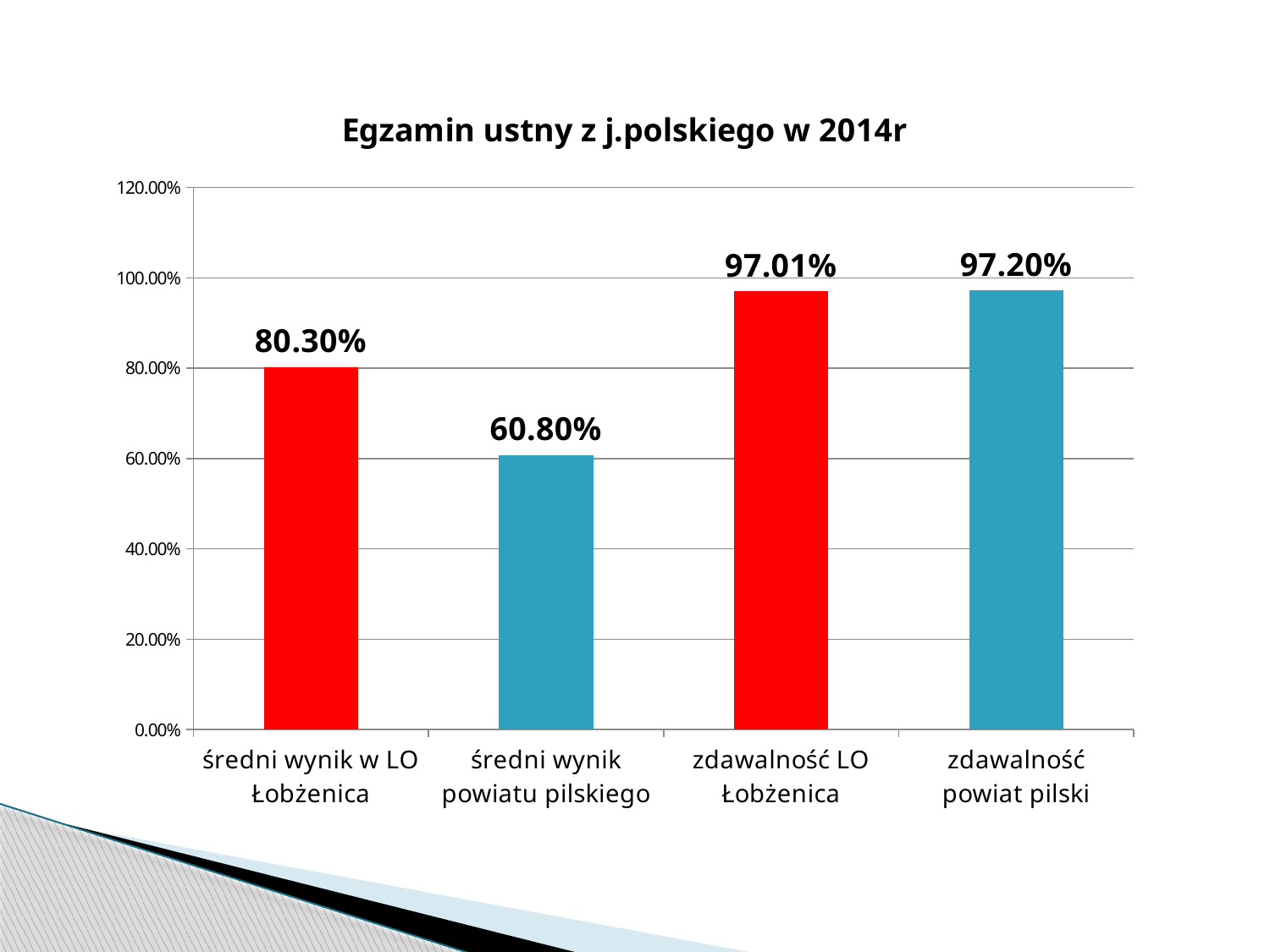
Which category has the lowest value? średni wynik powiatu pilskiego What is the value for 'średni wynik powiatu pilskiego'? 60.80% What is the value for 'zdawalność powiat pilski'? 97.20% What is the difference between 'zdawalność powiat pilski' and 'zdawalność LO Łobżenica'? 0.19 percentage points Which category has the highest value? zdawalność powiat pilski Is the value for 'średni wynik powiatu pilskiego' greater or less than 80.00%? less What type of chart is shown on the slide? bar chart Which is larger: 'średni wynik w LO Łobżenica' or 'średni wynik powiatu pilskiego'? średni wynik w LO Łobżenica What is the value for 'zdawalność LO Łobżenica'? 97.01% What is the difference between 'średni wynik w LO Łobżenica' and 'średni wynik powiatu pilskiego'? 19.50 percentage points What is the value for 'średni wynik w LO Łobżenica'? 80.30% How many categories are shown in the chart? 4